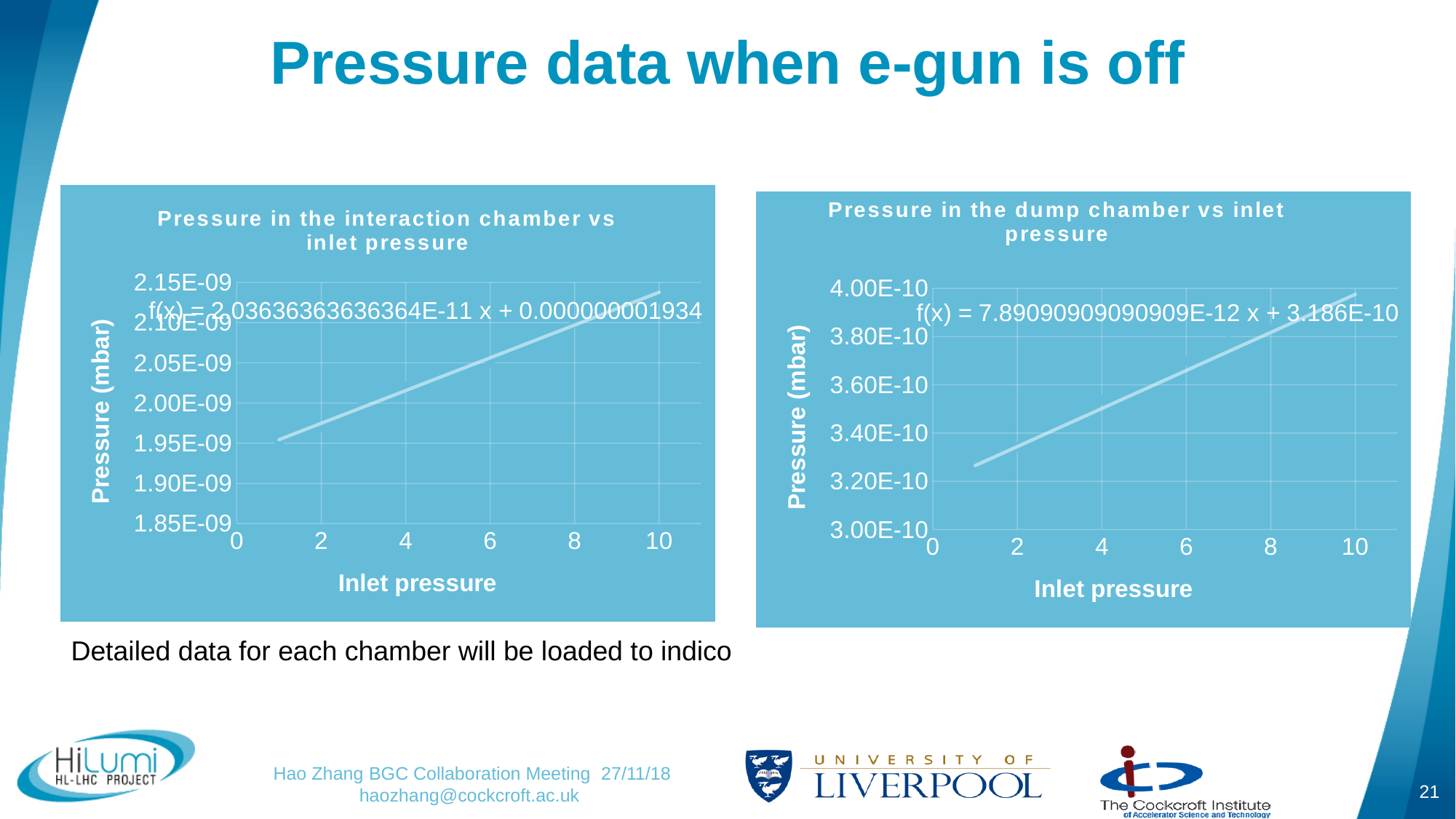
What is the y-axis label of the 'Pressure in the dump chamber vs inlet pressure' chart? Pressure (mbar) In the 'Pressure in the dump chamber vs inlet pressure' chart, is the pressure at inlet pressure 6 greater or less than 3.40E-10? greater In the 'Pressure in the dump chamber vs inlet pressure' chart, is the pressure at inlet pressure 10 greater or less than 3.80E-10? greater In the 'Pressure in the dump chamber vs inlet pressure' chart, does the pressure rise or fall as inlet pressure increases? rise What is the title of the chart on the left of the slide? Pressure in the interaction chamber vs inlet pressure What kind of chart is the 'Pressure in the interaction chamber vs inlet pressure' chart? line chart In the 'Pressure in the interaction chamber vs inlet pressure' chart, does the pressure rise or fall as inlet pressure increases? rise In the 'Pressure in the dump chamber vs inlet pressure' chart, is the pressure at inlet pressure 2 greater or less than 3.60E-10? less